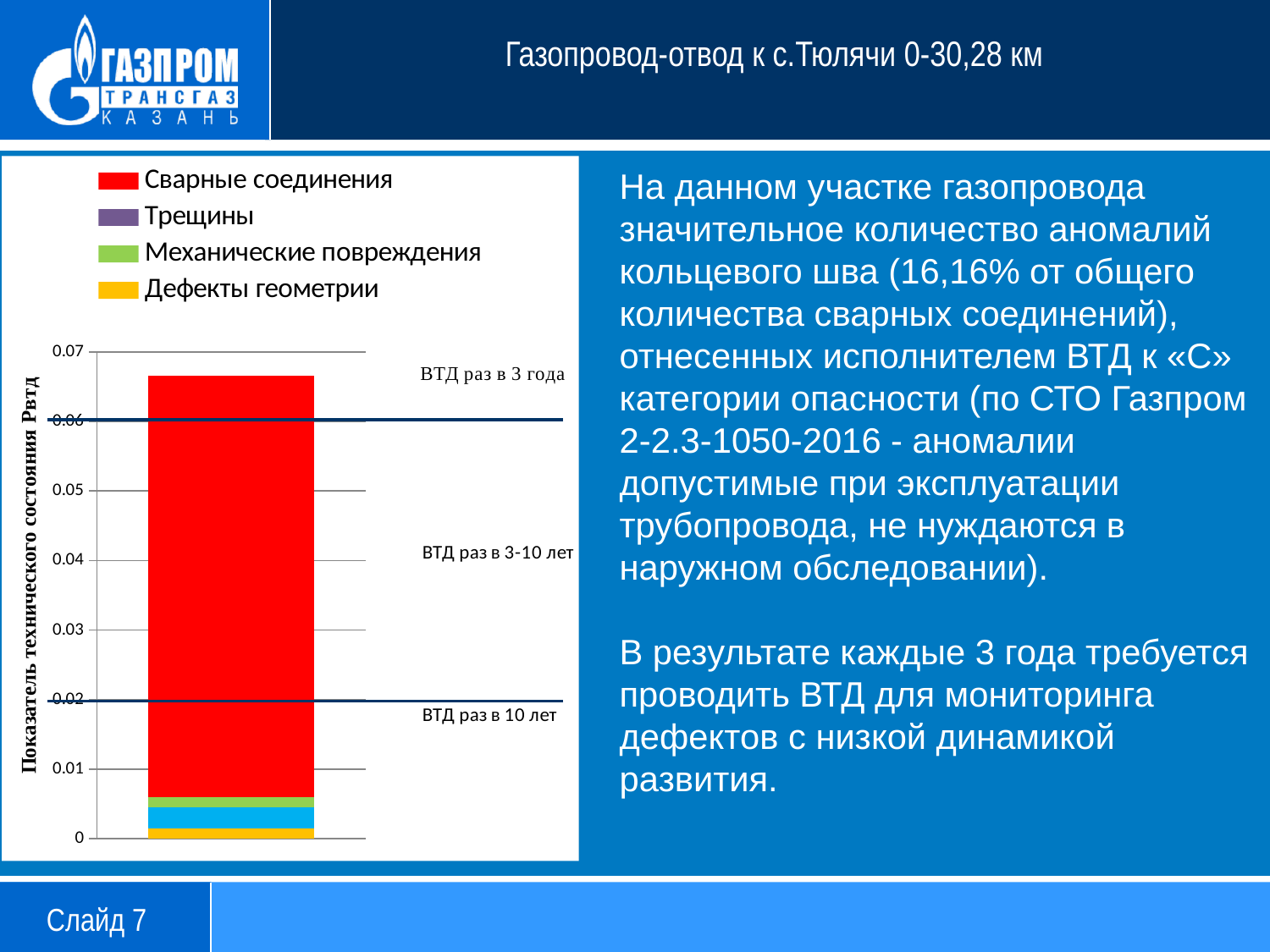
What kind of chart is shown on the slide? stacked bar chart What is the highest tick value shown on the vertical axis? 0.07 What colour represents Сварные соединения in the legend? red What label is attached to the horizontal reference line at 0.06? ВТД раз в 3 года Which is larger in the stacked bar: the Сварные соединения segment or the Механические повреждения segment? Сварные соединения How many series does the chart legend list? 4 What label is attached to the horizontal reference line at 0.02? ВТД раз в 10 лет How many bars are plotted in the chart? 1 Is the value of the Дефекты геометрии segment greater or less than 0.01? less Is the total height of the stacked bar greater or less than 0.07? less Which legend series occupies the largest part of the stacked bar? Сварные соединения Is the total height of the stacked bar greater or less than 0.06? greater